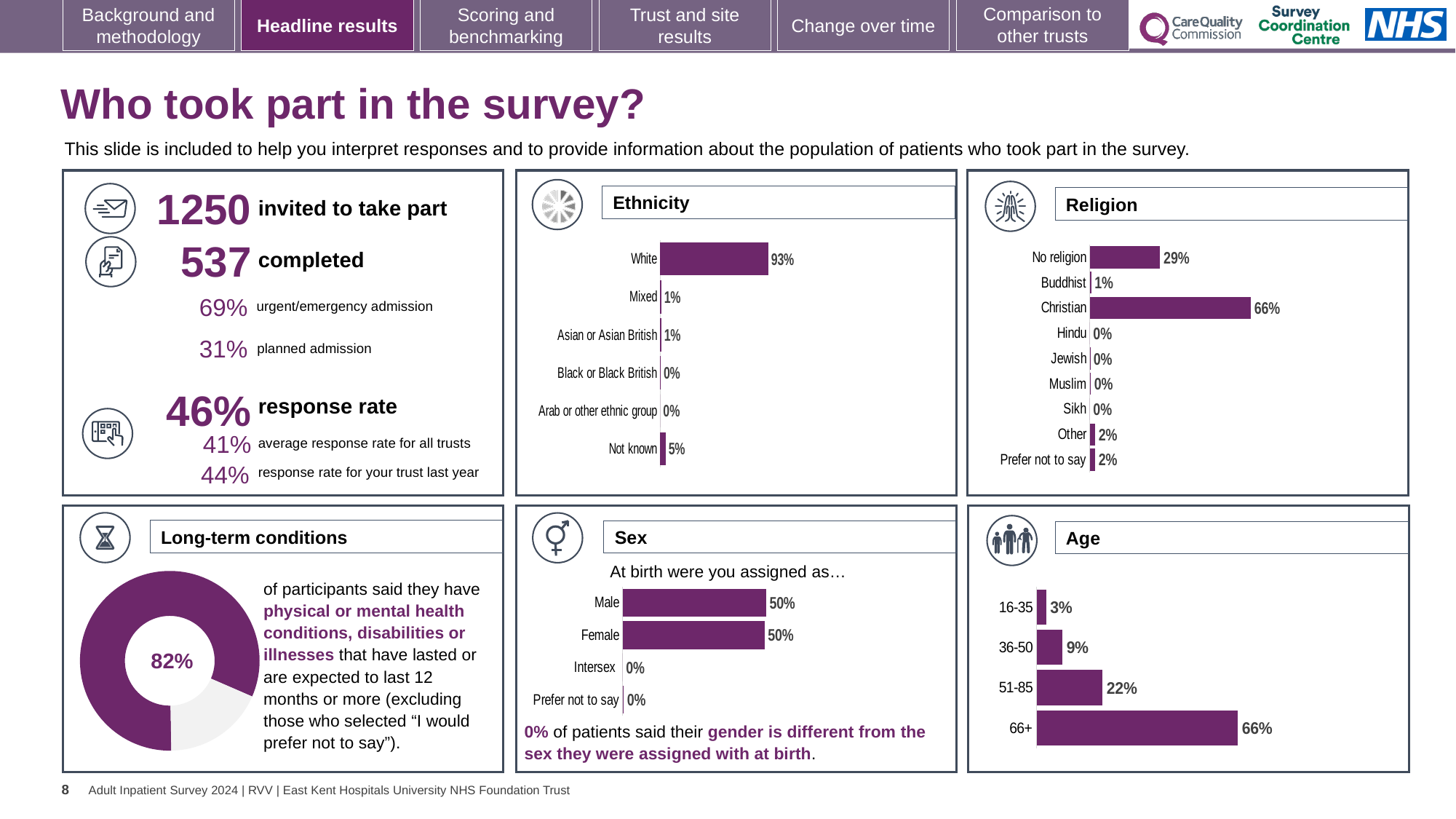
In the Ethnicity chart, what is the value for Not known? 5% In the Age chart, which age group has the highest value? 66+ In the Age chart, what is the value for 51-85? 22% In the Religion chart, what percentage of participants were Christian? 66% How many categories are shown in the Religion chart? 9 In the Ethnicity chart, what percentage of participants were White? 93% In the Sex chart, what percentage of participants were Female? 50% What kind of chart is the Long-term conditions chart? Doughnut chart In the Ethnicity chart, which category has the highest value? White In the Religion chart, what is the difference between Christian and No religion? 37% In the Long-term conditions chart, what share of participants said they have long-term conditions? 82% In the Age chart, which is larger, 36-50 or 16-35? 36-50